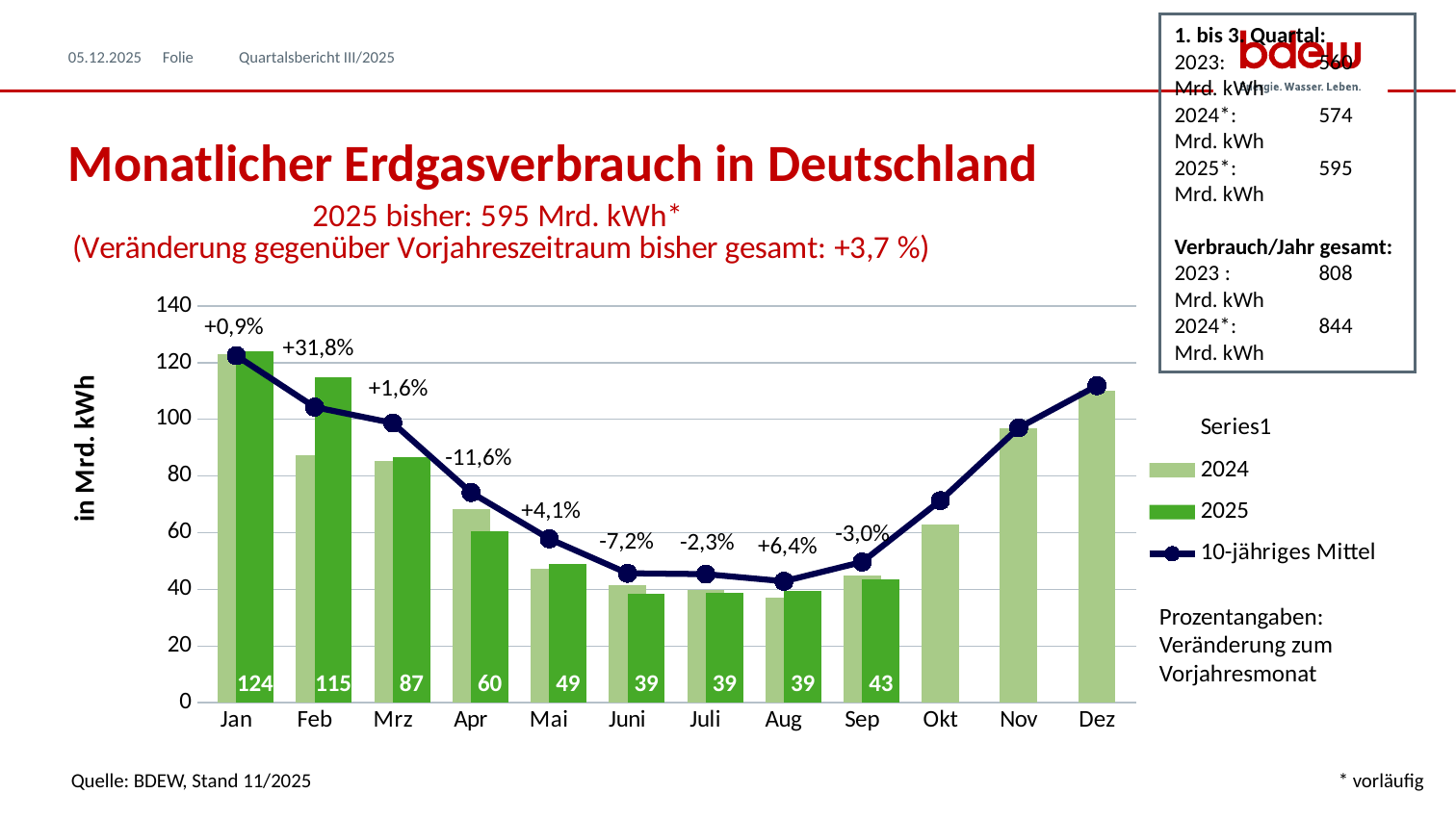
Which month has the highest 2025 value? Jan Is the 2024 value for Nov greater or less than 80? greater Which is larger, the 2025 value for Apr or for Mai? Apr What is the difference between the 2025 values for Mrz and Apr? 27 What percentage change is shown above the Feb bars? +31,8% What is the difference between the 2025 values for Jan and Feb? 9 How many months are shown on the x axis? 12 What is the 2025 value for Jan? 124 Do the 2025 values rise or fall from Jan to Aug? fall How many entries does the legend list? 4 What is the 2025 value for Sep? 43 What is the label on the y axis? in Mrd. kWh